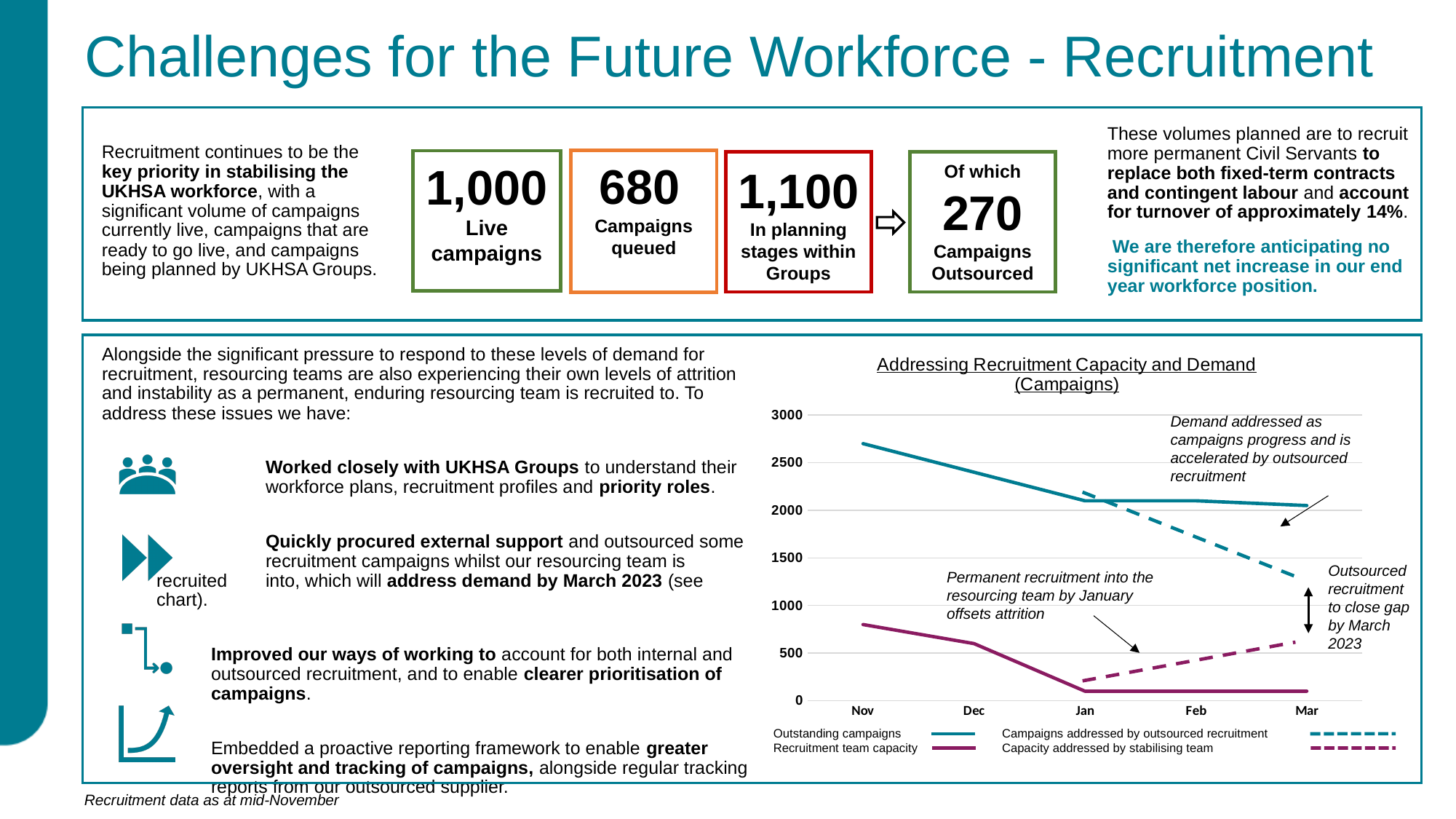
In the 'Addressing Recruitment Capacity and Demand (Campaigns)' chart, is the value for Outstanding campaigns in Nov greater or less than 2500? greater In the 'Addressing Recruitment Capacity and Demand (Campaigns)' chart, which legend series is drawn as a solid purple line? Recruitment team capacity In the 'Addressing Recruitment Capacity and Demand (Campaigns)' chart, does the Capacity addressed by stabilising team line rise or fall from Jan to Mar? Rise How many series does the legend of the 'Addressing Recruitment Capacity and Demand (Campaigns)' chart list? 4 In the 'Addressing Recruitment Capacity and Demand (Campaigns)' chart, is the value for Outstanding campaigns in Mar greater or less than 2500? less In the 'Addressing Recruitment Capacity and Demand (Campaigns)' chart, which is larger in Nov: Outstanding campaigns or Recruitment team capacity? Outstanding campaigns In the 'Addressing Recruitment Capacity and Demand (Campaigns)' chart, is the value for Recruitment team capacity in Jan greater or less than 500? less How many months are shown on the x axis of the 'Addressing Recruitment Capacity and Demand (Campaigns)' chart? 5 In the 'Addressing Recruitment Capacity and Demand (Campaigns)' chart, does the Outstanding campaigns line rise or fall from Nov to Mar? Fall What kind of chart is shown under the title 'Addressing Recruitment Capacity and Demand (Campaigns)'? Line chart